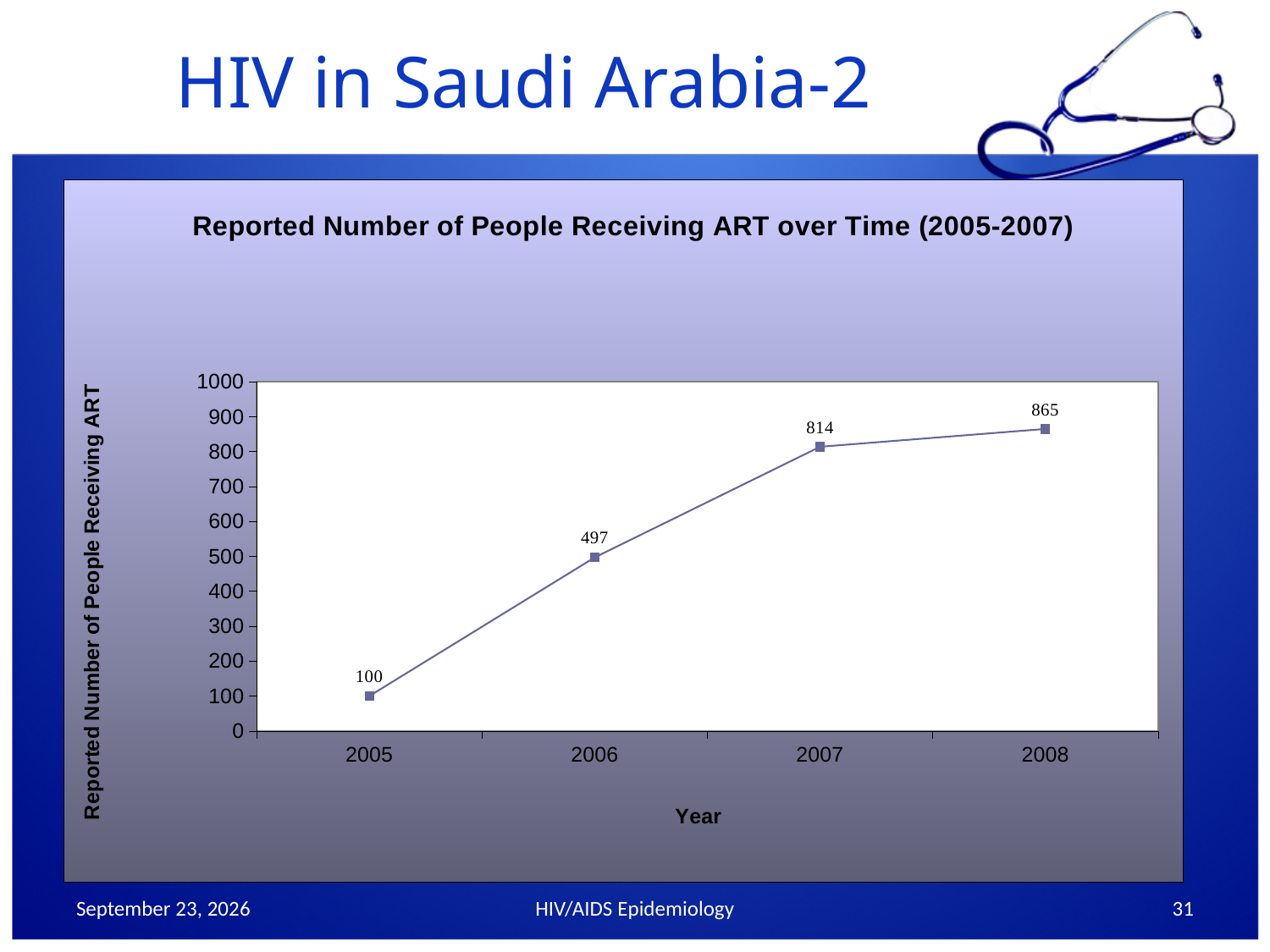
By how much did the reported number of people receiving ART increase from 2005 to 2008? 765 Which year has the lowest reported number of people receiving ART? 2005 What kind of chart is shown on the slide? Line chart What is the reported number of people receiving ART in 2008? 865 How many years are plotted on the chart? 4 What is the reported number of people receiving ART in 2006? 497 Which year has a larger reported number of people receiving ART, 2006 or 2007? 2007 What is the reported number of people receiving ART in 2005? 100 What is the title of the chart? Reported Number of People Receiving ART over Time (2005-2007) What is the difference between the number of people receiving ART in 2007 and in 2006? 317 Does the reported number of people receiving ART rise or fall from 2005 to 2008? Rise Which year has the highest reported number of people receiving ART? 2008